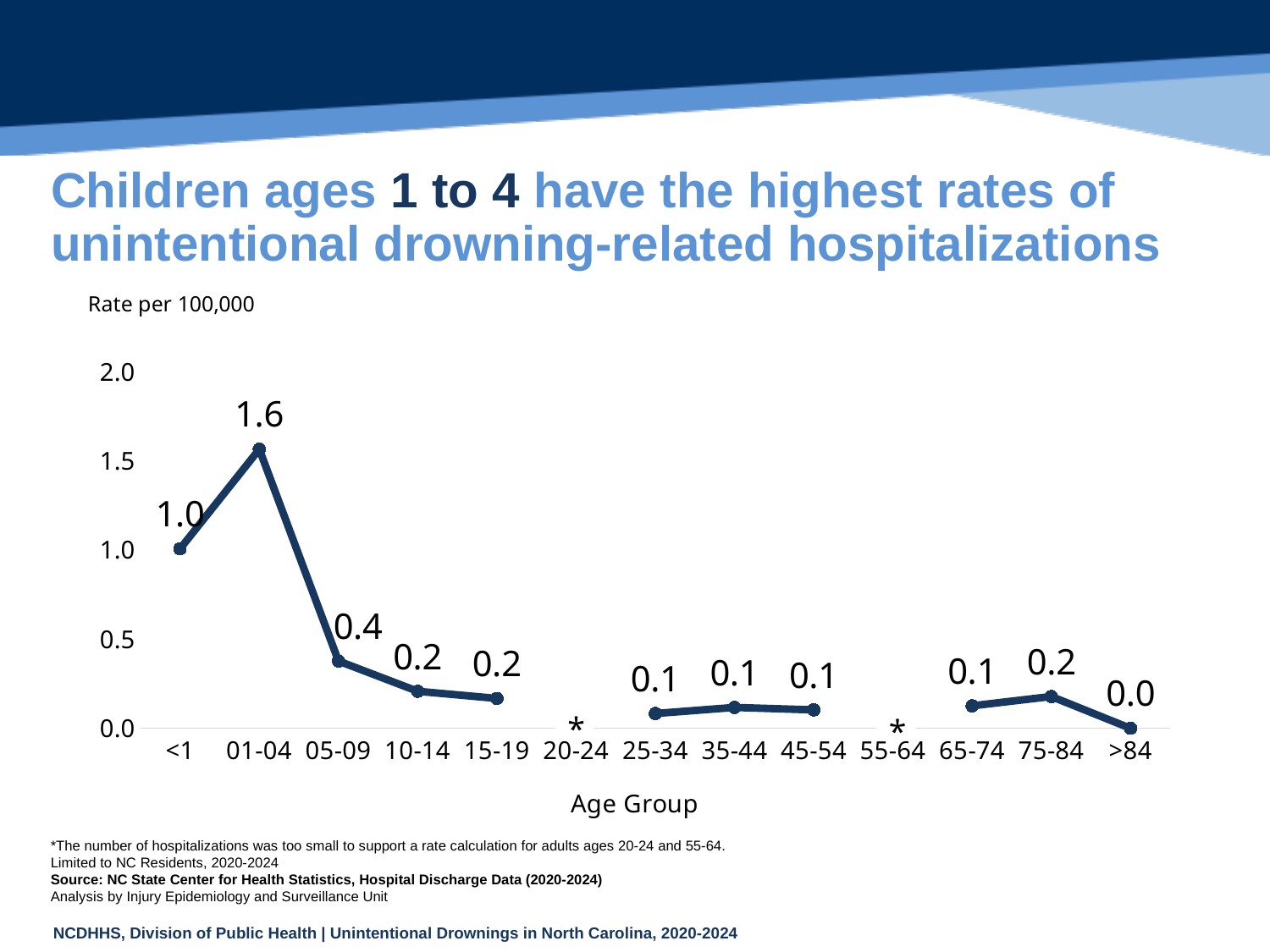
Which age group has the highest rate of unintentional drowning-related hospitalizations? 01-04 What type of chart is shown on the slide? line chart What is the rate per 100,000 for the >84 age group? 0.0 What is the rate per 100,000 for the <1 age group? 1.0 What is the rate per 100,000 for the 01-04 age group? 1.6 Which has a higher rate, the 05-09 age group or the 75-84 age group? 05-09 What is the rate per 100,000 for the 05-09 age group? 0.4 Which two age groups are marked with an asterisk because the number of hospitalizations was too small to calculate a rate? 20-24 and 55-64 What is the difference between the rates for the 01-04 and <1 age groups? 0.6 Which age group has the lowest plotted rate? >84 Is the value for the 01-04 age group greater or less than 1.5? greater How many age groups are labeled on the x axis? 13